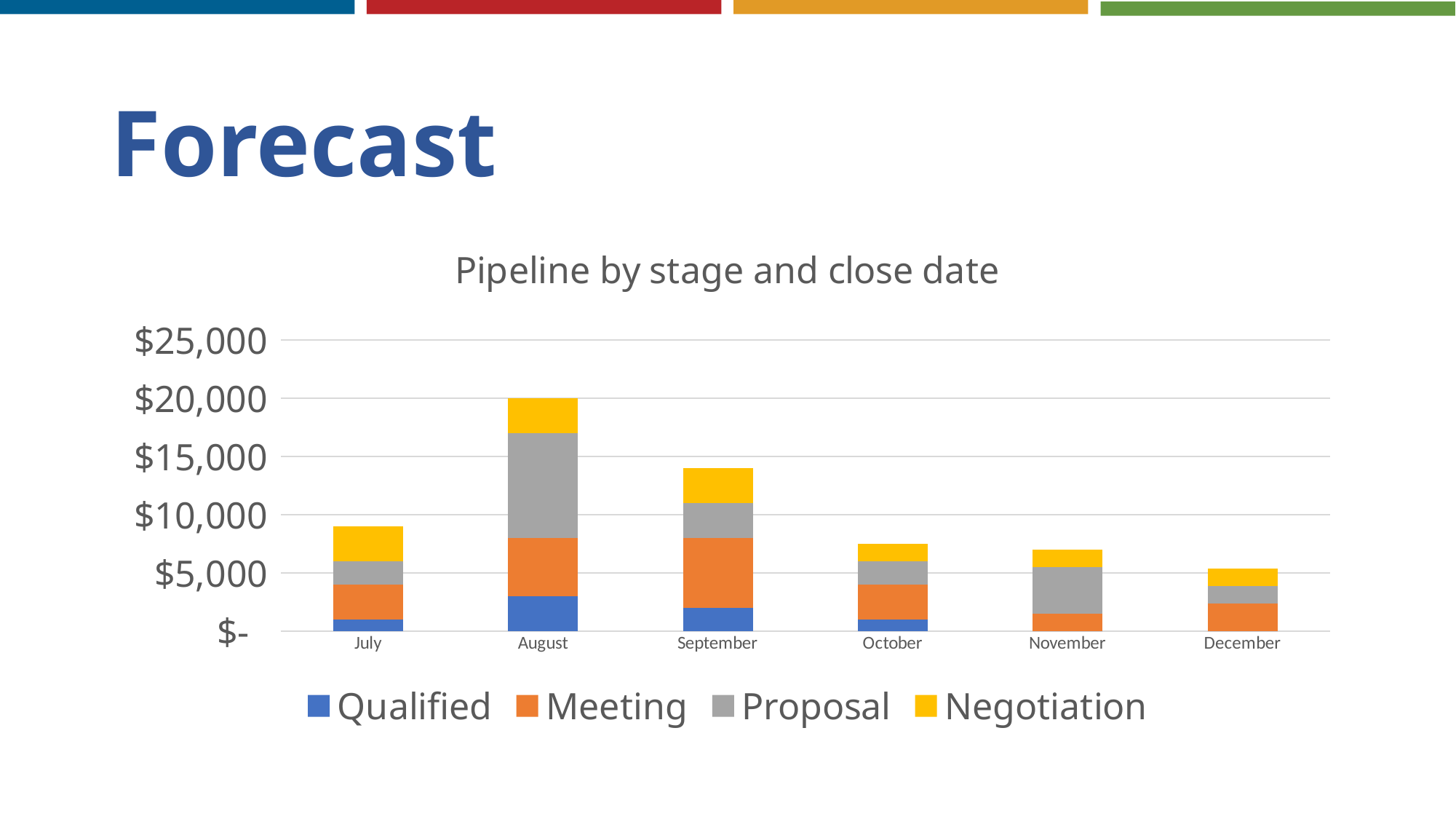
What type of chart is shown on the slide? Stacked bar chart Is the total pipeline for September greater or less than $10,000? greater What is the title of the chart? Pipeline by stage and close date How many series does the legend list? 4 Is the total pipeline for July greater or less than $10,000? less Which month has a larger total pipeline, September or October? September Is the total pipeline for October greater or less than $10,000? less What is the total pipeline value for August? $20,000 Which month has the highest total pipeline? August How many months are shown on the x axis? 6 Which colour represents the Negotiation stage in the legend? Yellow Which month has the lowest total pipeline? December